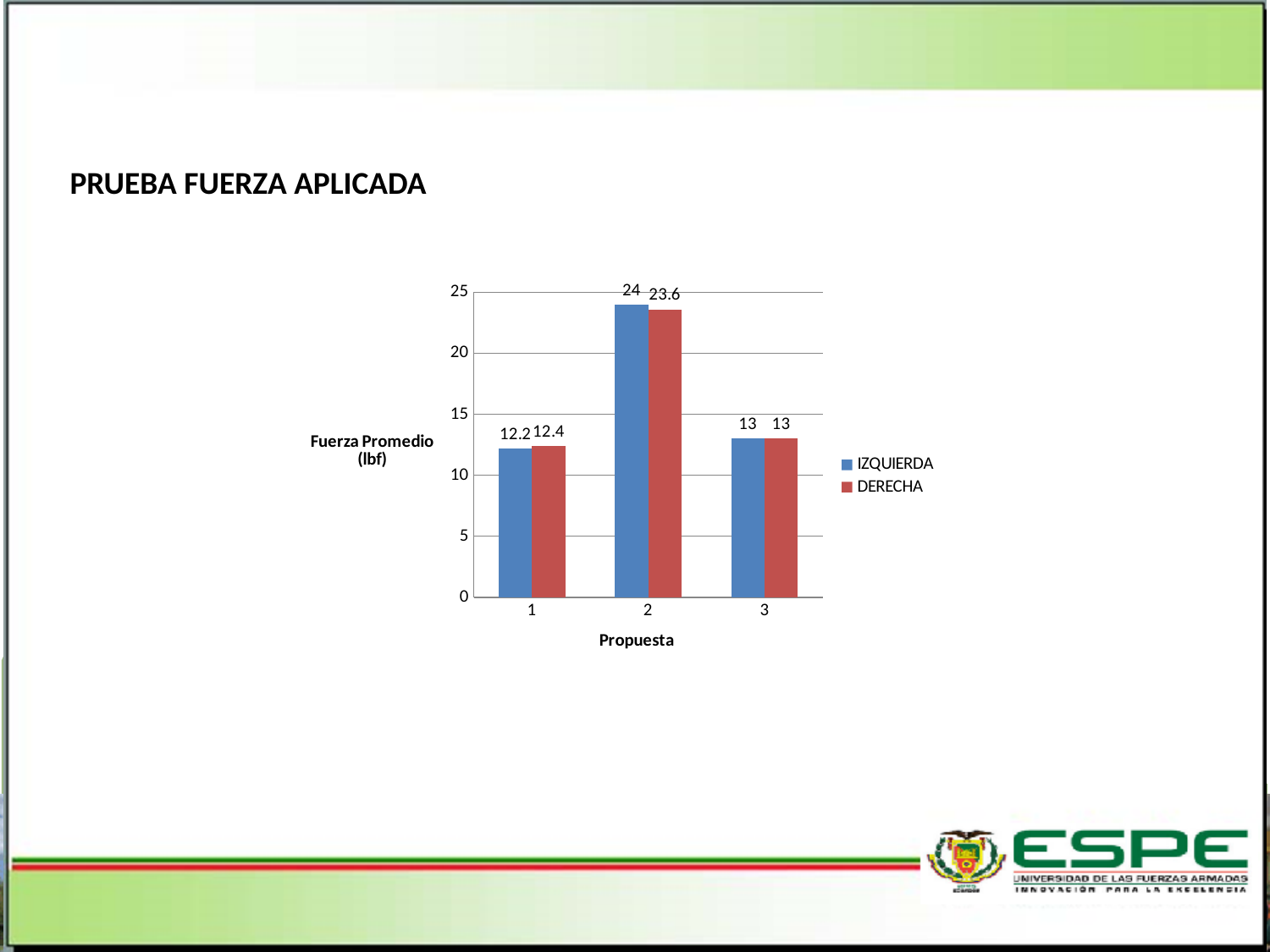
What is the difference between the IZQUIERDA values for Propuesta 2 and Propuesta 3? 11 Is the DERECHA value for Propuesta 2 greater or less than 20? greater Which Propuesta has the lowest DERECHA value? 1 What kind of chart is shown on the slide? bar chart What is the IZQUIERDA value for Propuesta 3? 13 What is the difference between the IZQUIERDA and DERECHA values for Propuesta 2? 0.4 How many Propuesta categories are shown on the x axis? 3 What is the DERECHA value for Propuesta 2? 23.6 What is the IZQUIERDA value for Propuesta 1? 12.2 Which is larger, the IZQUIERDA value for Propuesta 2 or the IZQUIERDA value for Propuesta 1? Propuesta 2 Which Propuesta has the highest IZQUIERDA value? 2 How many series does the legend list? 2